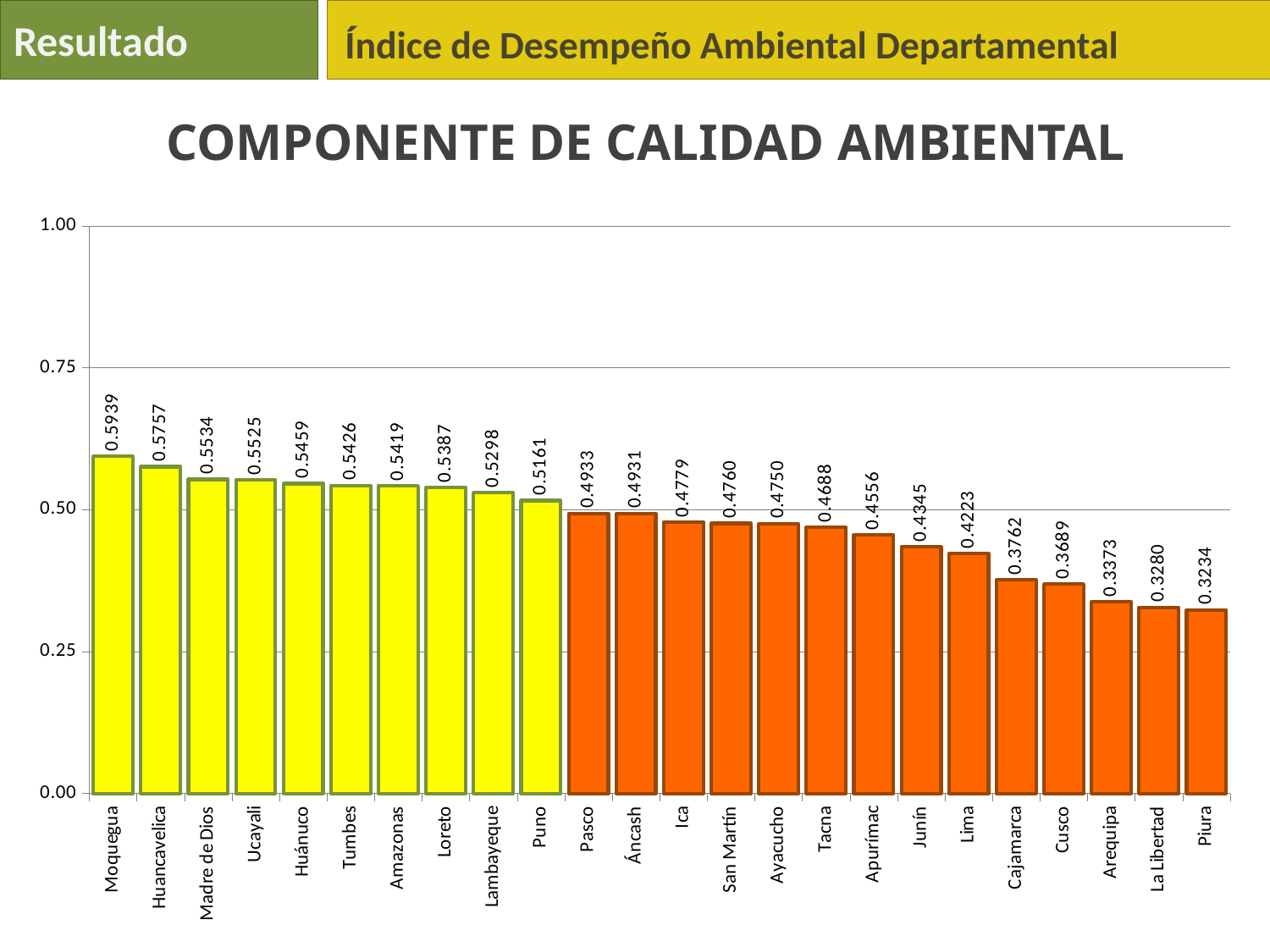
What is the difference between the values for Moquegua and Piura? 0.2705 What is the value for Moquegua? 0.5939 Which has a larger value, Huancavelica or Cajamarca? Huancavelica Do the values rise or fall from left to right along the x axis? fall Which department has the highest value? Moquegua What is the value for Lima? 0.4223 What is the difference between the values for Puno and Pasco? 0.0228 How many departments are shown in the chart? 24 What kind of chart is shown on the slide? bar chart What is the value for Cusco? 0.3689 Is the value for Arequipa greater or less than 0.50? less Which department has the lowest value? Piura